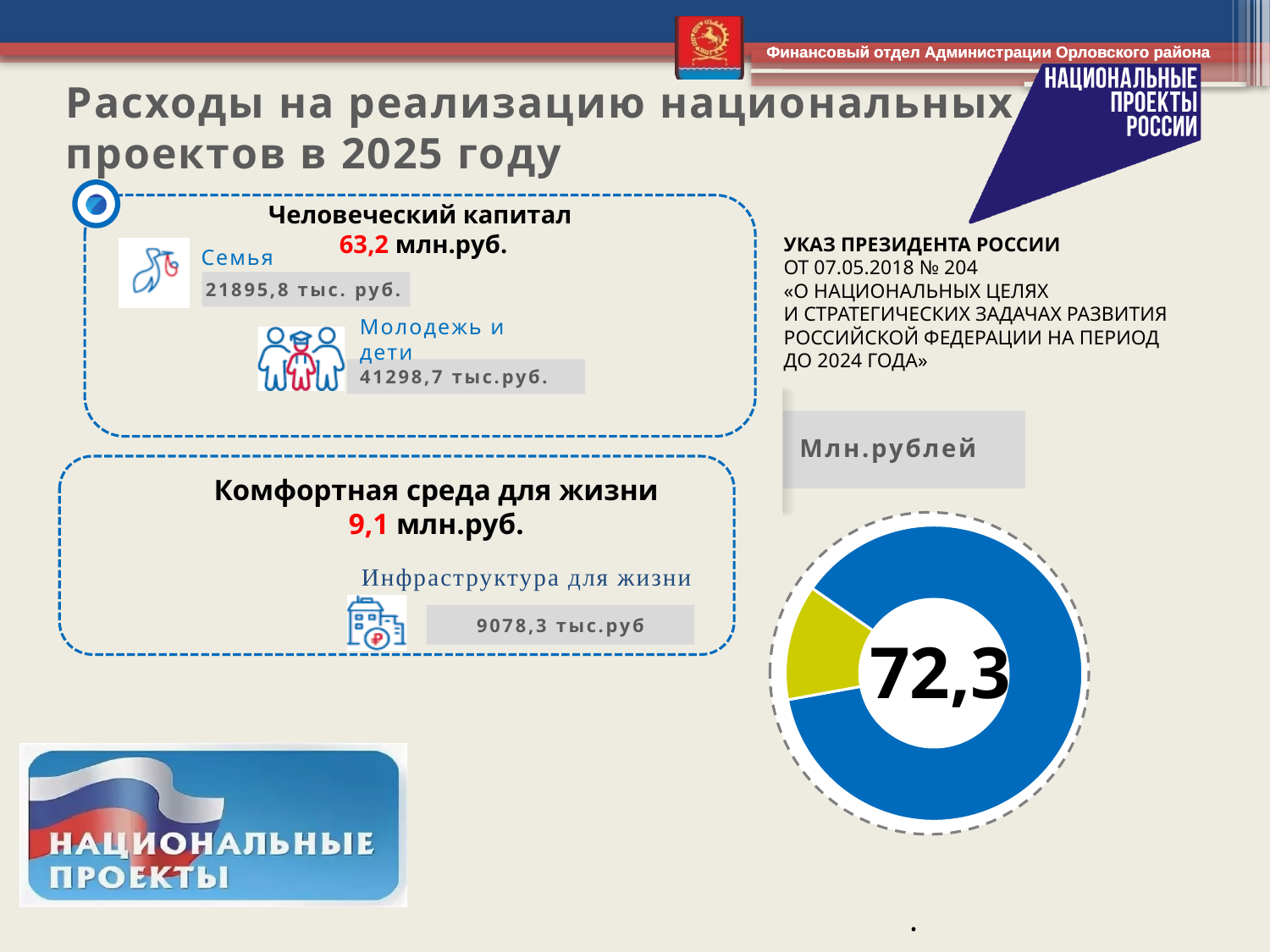
What value is printed in the centre of the doughnut chart? 72,3 Which slice of the doughnut chart is the smallest? the yellow-green slice What colour is the largest slice of the doughnut chart? blue What kind of chart is shown on the right side of the slide? doughnut (pie) chart What unit is given in the label above the doughnut chart? Млн.рублей How many slices does the doughnut chart have? 2 Which slice of the doughnut chart is larger, the blue one or the yellow-green one? the blue one